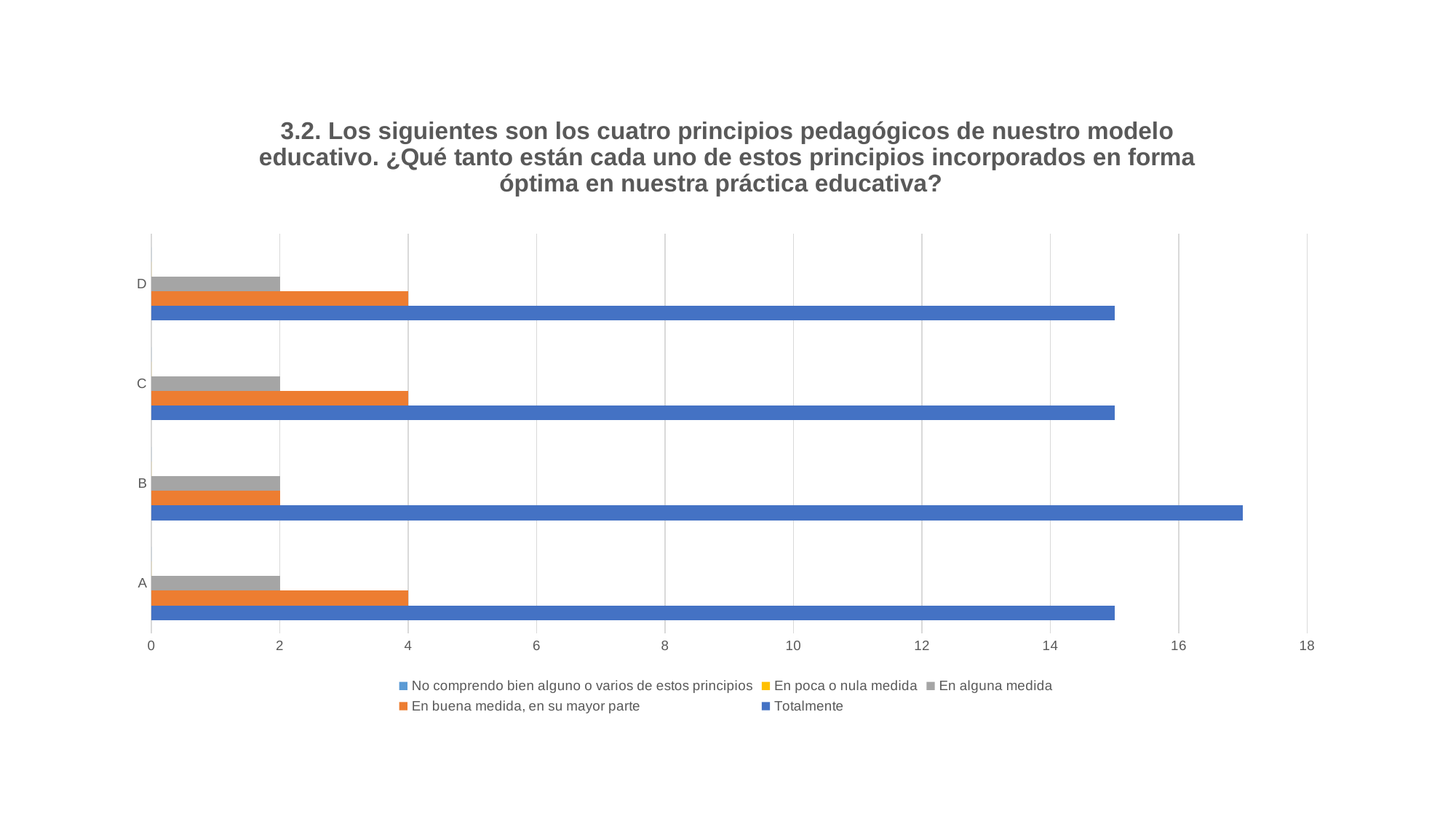
What is the value of 'En alguna medida' for category C? 2 What is the value of 'En buena medida, en su mayor parte' for category A? 4 Which is larger: the 'Totalmente' value for B or for C? B Which category has the highest value for 'Totalmente'? B What is the difference between the 'En buena medida, en su mayor parte' values for A and B? 2 How many series does the legend list? 5 What kind of chart is shown on the slide? bar chart Which series is shown in orange in the legend? En buena medida, en su mayor parte How many categories are shown on the vertical axis of the chart? 4 Is the 'Totalmente' value for category D greater or less than 16? less Is the 'Totalmente' value for category B greater or less than 16? greater What is the value of 'En buena medida, en su mayor parte' for category B? 2